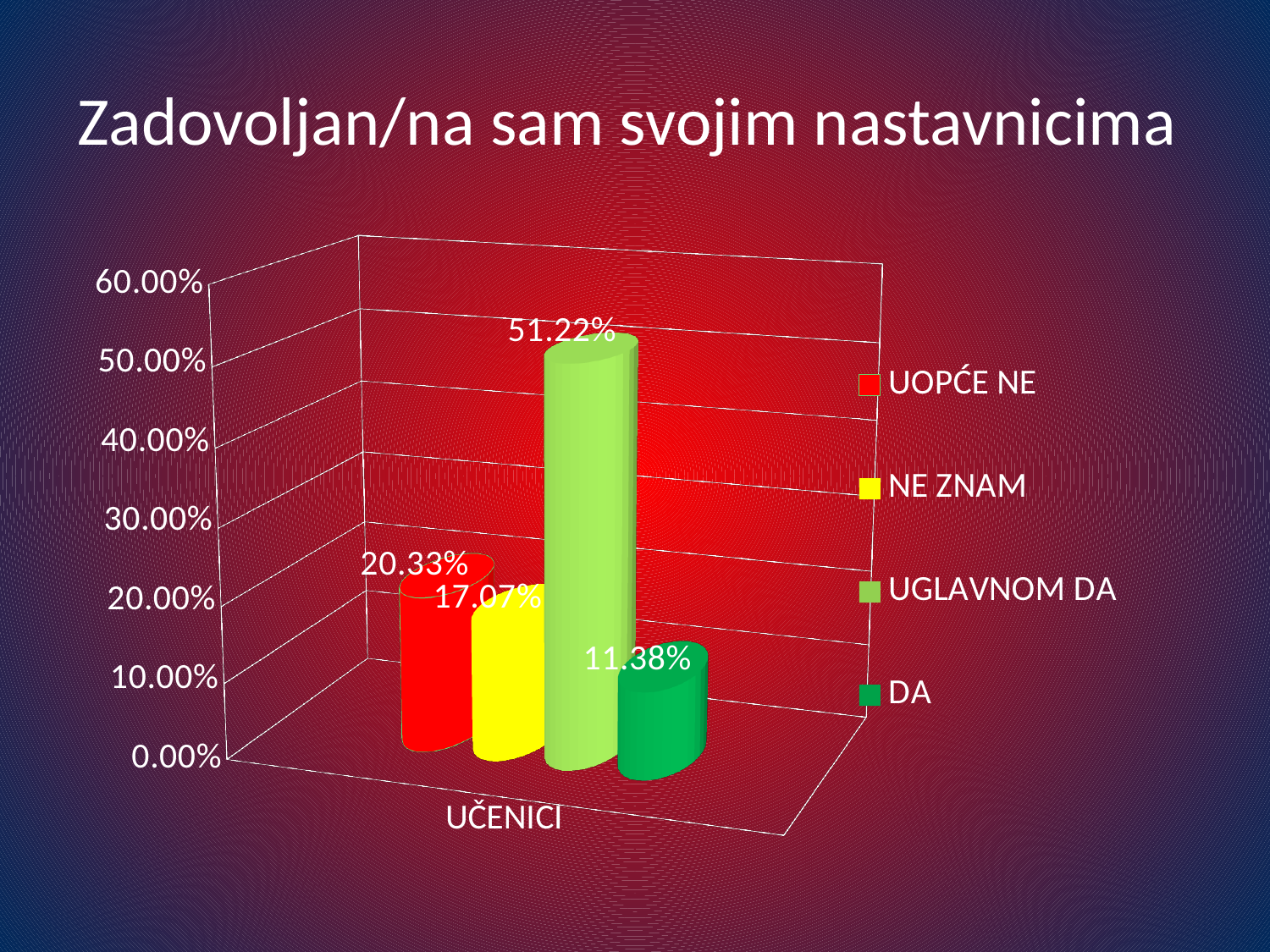
What is the value for DA? 11.38% What is the value for UOPĆE NE? 20.33% Is the value for UGLAVNOM DA greater or less than 50.00%? greater Which series has the highest value? UGLAVNOM DA Which series has the lowest value? DA What is the value for UGLAVNOM DA? 51.22% What is the title of the chart? Zadovoljan/na sam svojim nastavnicima What is the difference between the values for UGLAVNOM DA and DA? 39.84% Which is larger, the value for UOPĆE NE or the value for NE ZNAM? UOPĆE NE How many series does the legend list? 4 What is the difference between the values for UOPĆE NE and NE ZNAM? 3.26% What is the value for NE ZNAM? 17.07%